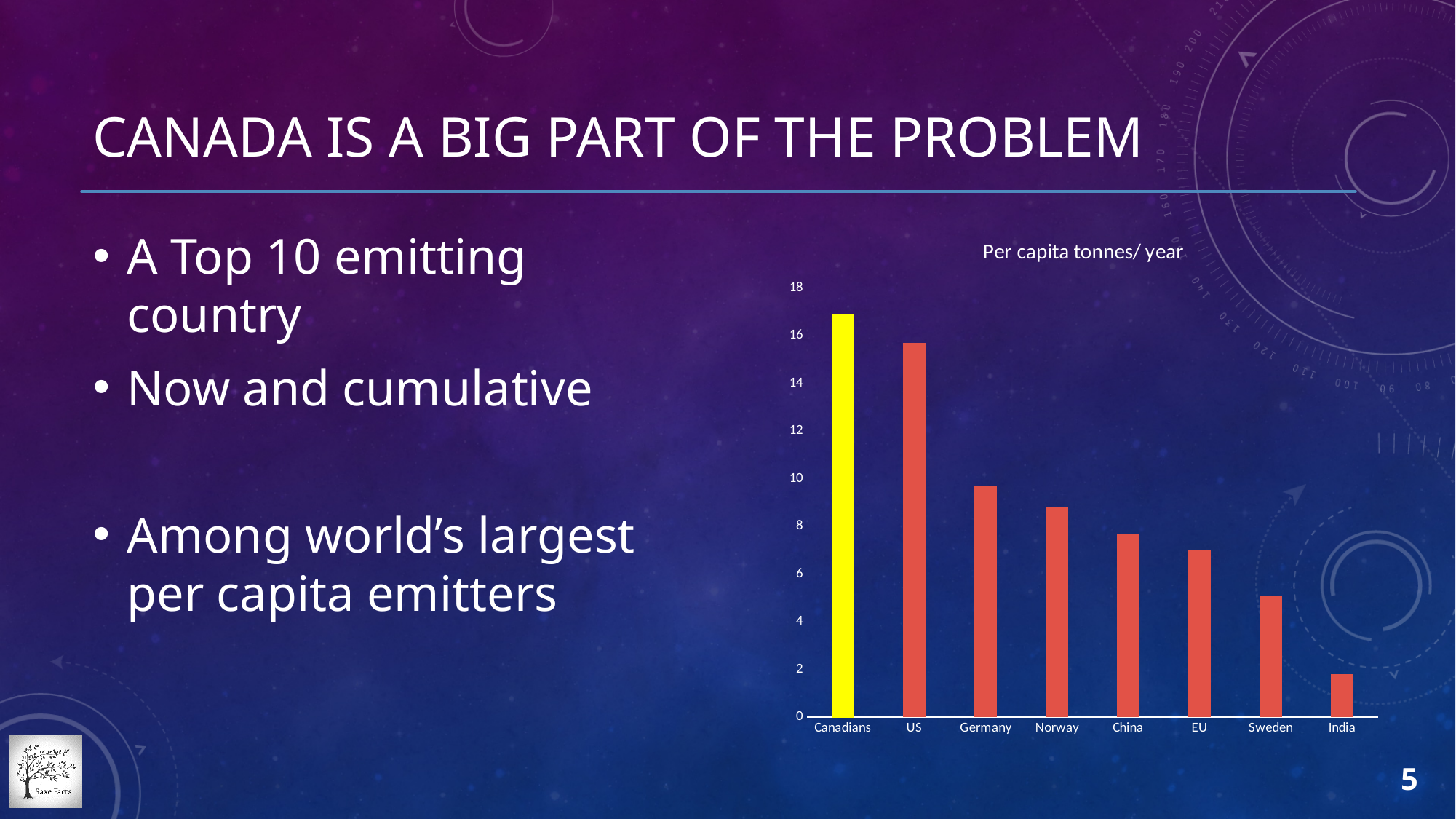
Is the value for Canadians greater or less than 16? greater What kind of chart is shown on the slide? bar chart What is the title of the chart? Per capita tonnes/ year How many categories are plotted in the chart? 8 What colour is the bar for Canadians? yellow Is the value for Norway greater or less than 8? greater Which has a larger value, US or Germany? US Do the values rise or fall moving from left to right along the x axis? fall Which category has the highest value in the chart? Canadians Is the value for US greater or less than 16? less Which category has the lowest value in the chart? India